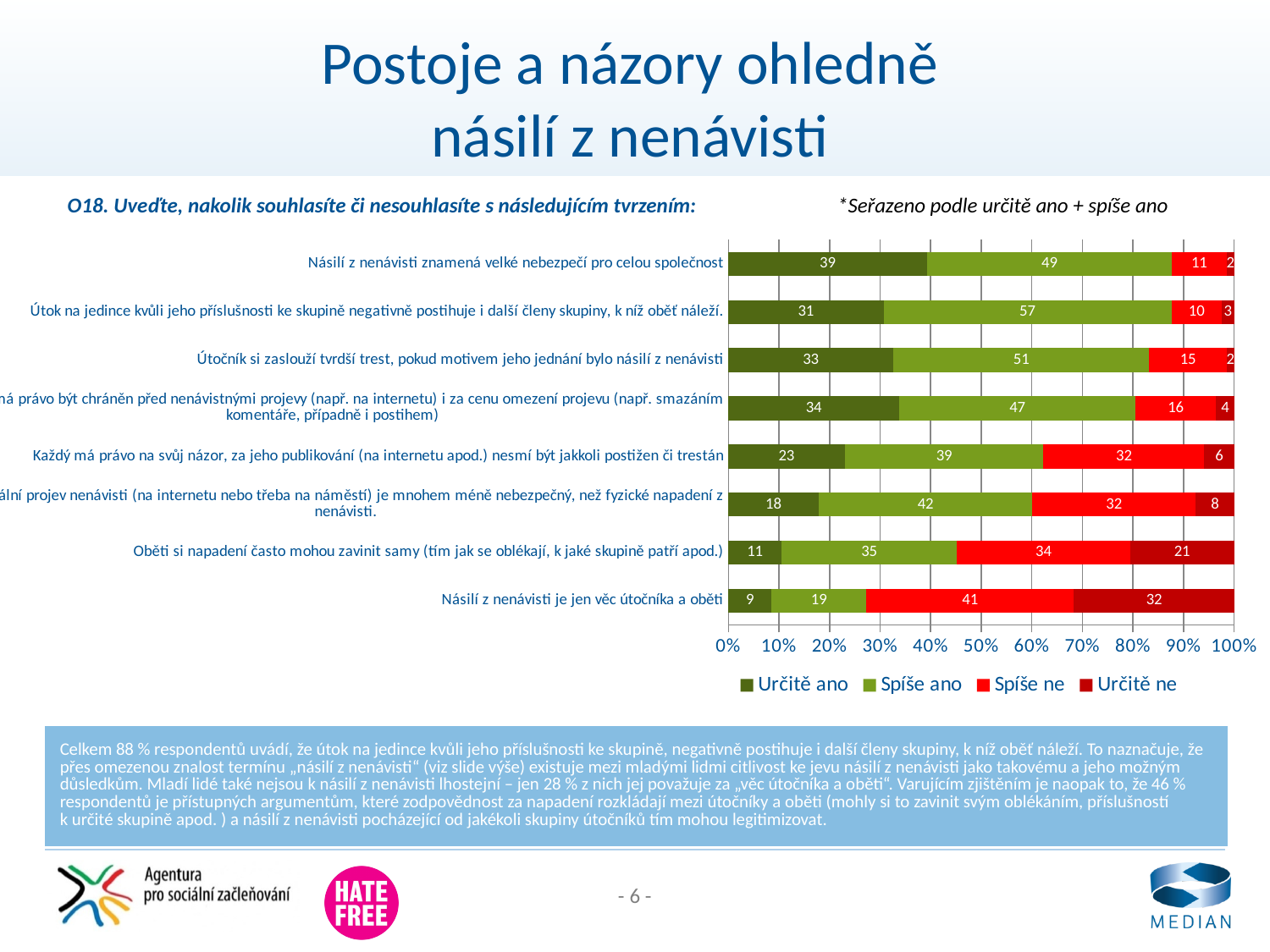
What is the 'Spíše ano' value for the statement 'Útok na jedince kvůli jeho příslušnosti ke skupině negativně postihuje i další členy skupiny, k níž oběť náleží.'? 57 What is the difference between the 'Spíše ne' values for 'Násilí z nenávisti je jen věc útočníka a oběti' and 'Oběti si napadení často mohou zavinit samy (tím jak se oblékají, k jaké skupině patří apod.)'? 7 How many series does the chart legend list? 4 Which statement has the highest 'Určitě ano' value? Násilí z nenávisti znamená velké nebezpečí pro celou společnost What is the 'Určitě ano' value for the statement 'Násilí z nenávisti znamená velké nebezpečí pro celou společnost'? 39 What is the 'Určitě ne' value for the statement 'Násilí z nenávisti je jen věc útočníka a oběti'? 32 Which statement has the lowest 'Určitě ano' value? Násilí z nenávisti je jen věc útočníka a oběti What type of chart is shown on the slide? Stacked bar chart How many statements (bars) are plotted in the chart? 8 Which legend entry is shown in dark red? Určitě ne Which is larger: the 'Spíše ano' value for 'Útočník si zaslouží tvrdší trest, pokud motivem jeho jednání bylo násilí z nenávisti' or for 'Každý má právo na svůj názor, za jeho publikování (na internetu apod.) nesmí být jakkoli postižen či trestán'? Útočník si zaslouží tvrdší trest, pokud motivem jeho jednání bylo násilí z nenávisti What is the combined 'Určitě ano' plus 'Spíše ano' value for the statement 'Násilí z nenávisti znamená velké nebezpečí pro celou společnost'? 88